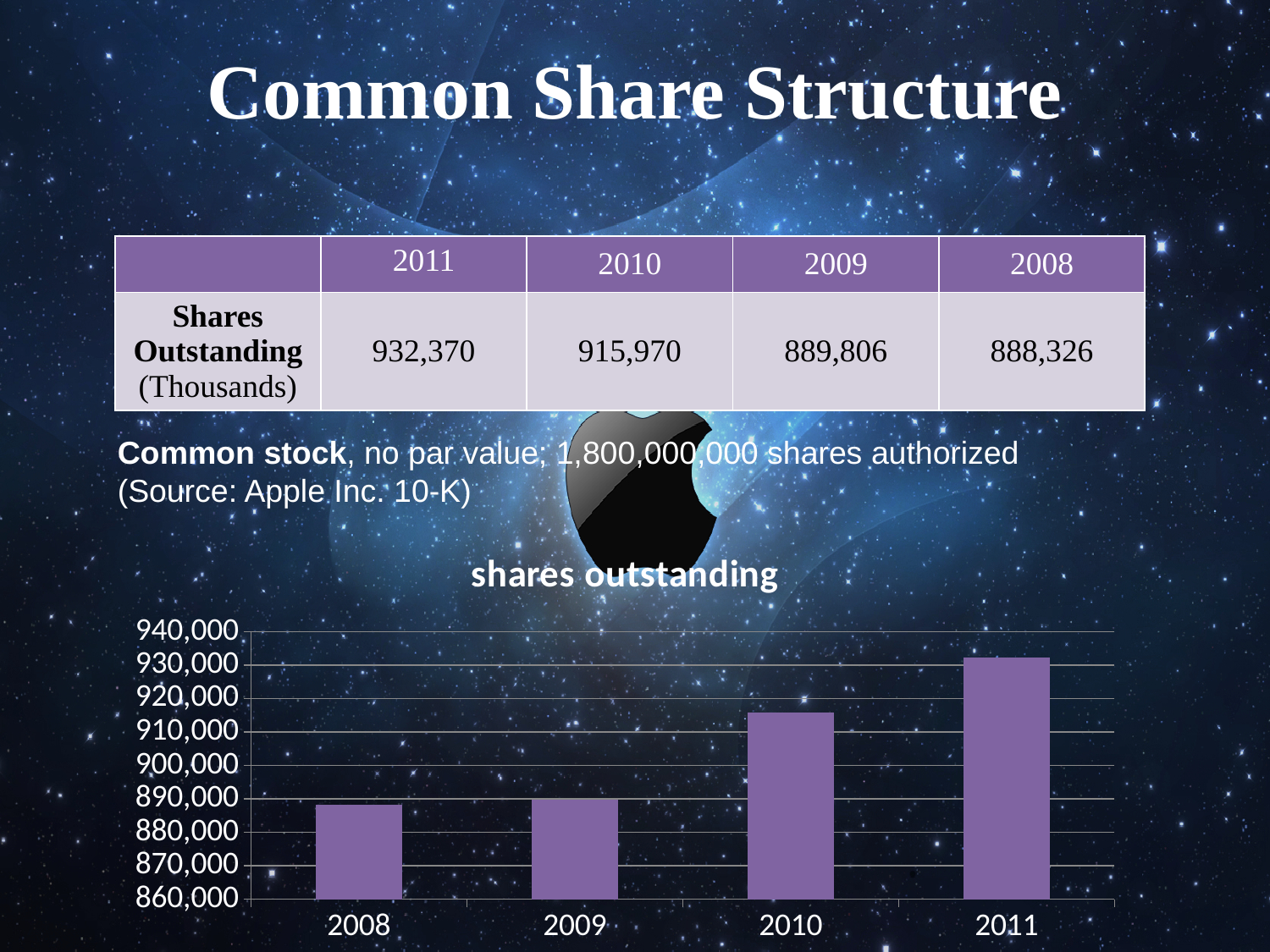
What is the title of the chart on the slide? shares outstanding What type of chart is shown on the slide? bar chart According to the table, what were the shares outstanding (thousands) in 2011? 932,370 Is the shares outstanding value for 2010 greater or less than 910,000? greater Do the shares outstanding rise or fall from 2008 to 2011 in the chart? rise According to the table, what were the shares outstanding (thousands) in 2008? 888,326 Using the table values, what is the difference in shares outstanding (thousands) between 2011 and 2010? 16,400 How many years are plotted in the shares outstanding chart? 4 Which year has larger shares outstanding, 2010 or 2009? 2010 Which year has the highest shares outstanding in the chart? 2011 Is the shares outstanding value for 2011 greater or less than 920,000? greater Is the shares outstanding value for 2008 greater or less than 880,000? greater